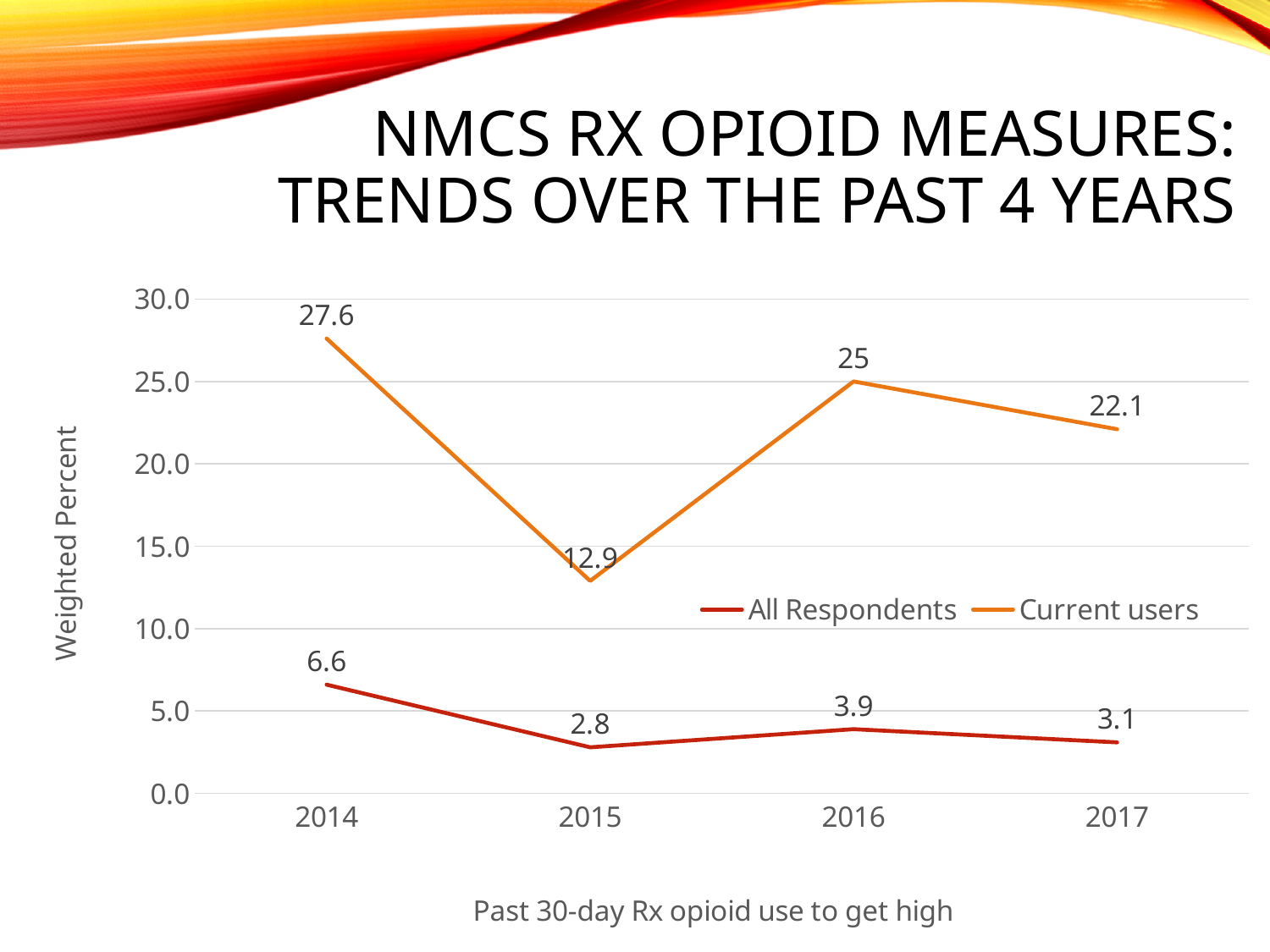
Which is larger: the All Respondents value in 2016 or in 2017? 2016 In which year is the All Respondents value highest? 2014 Did the All Respondents value rise or fall from 2014 to 2015? Fall What is the difference between the Current users value in 2014 and in 2015? 14.7 How many series does the legend list? 2 What is the value for Current users in 2014? 27.6 What kind of chart is shown on the slide? Line chart In which year is the Current users value lowest? 2015 What is the label of the y axis? Weighted Percent How many years are shown on the x axis? 4 What is the value for All Respondents in 2016? 3.9 What is the value for Current users in 2017? 22.1